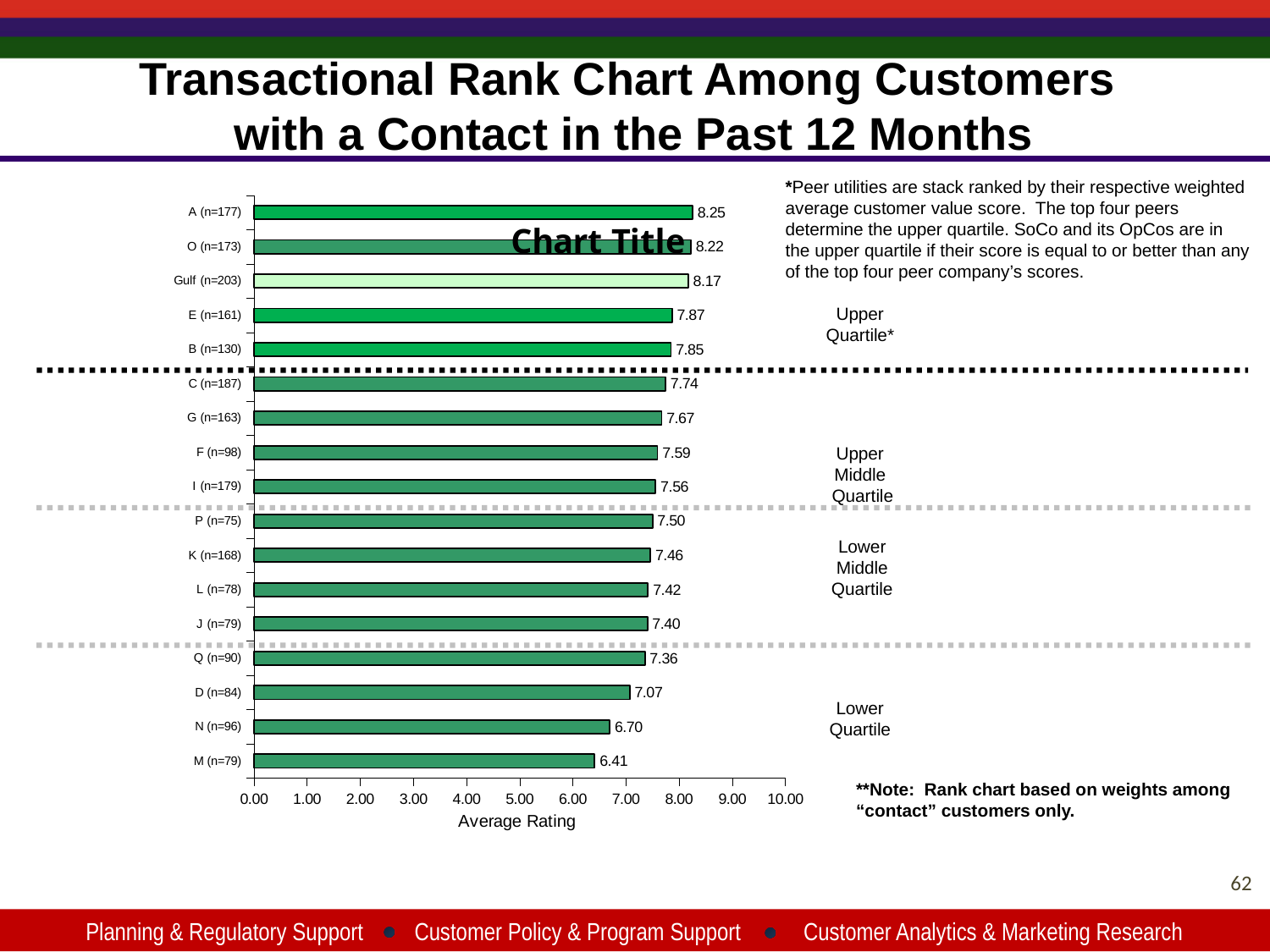
How many categories are shown in the chart? 17 What is the label of the horizontal axis? Average Rating What type of chart is shown on the slide? bar chart Is the average rating for C (n=187) greater or less than 8.00? less What is the difference between the average ratings of E (n=161) and B (n=130)? 0.02 Which category has the highest average rating? A (n=177) What is the difference between the average ratings of A (n=177) and M (n=79)? 1.84 What is the average rating for Gulf (n=203)? 8.17 Which category has the lowest average rating? M (n=79) What is the average rating for K (n=168)? 7.46 What is the average rating for N (n=96)? 6.70 Which has a higher average rating, D (n=84) or Q (n=90)? Q (n=90)